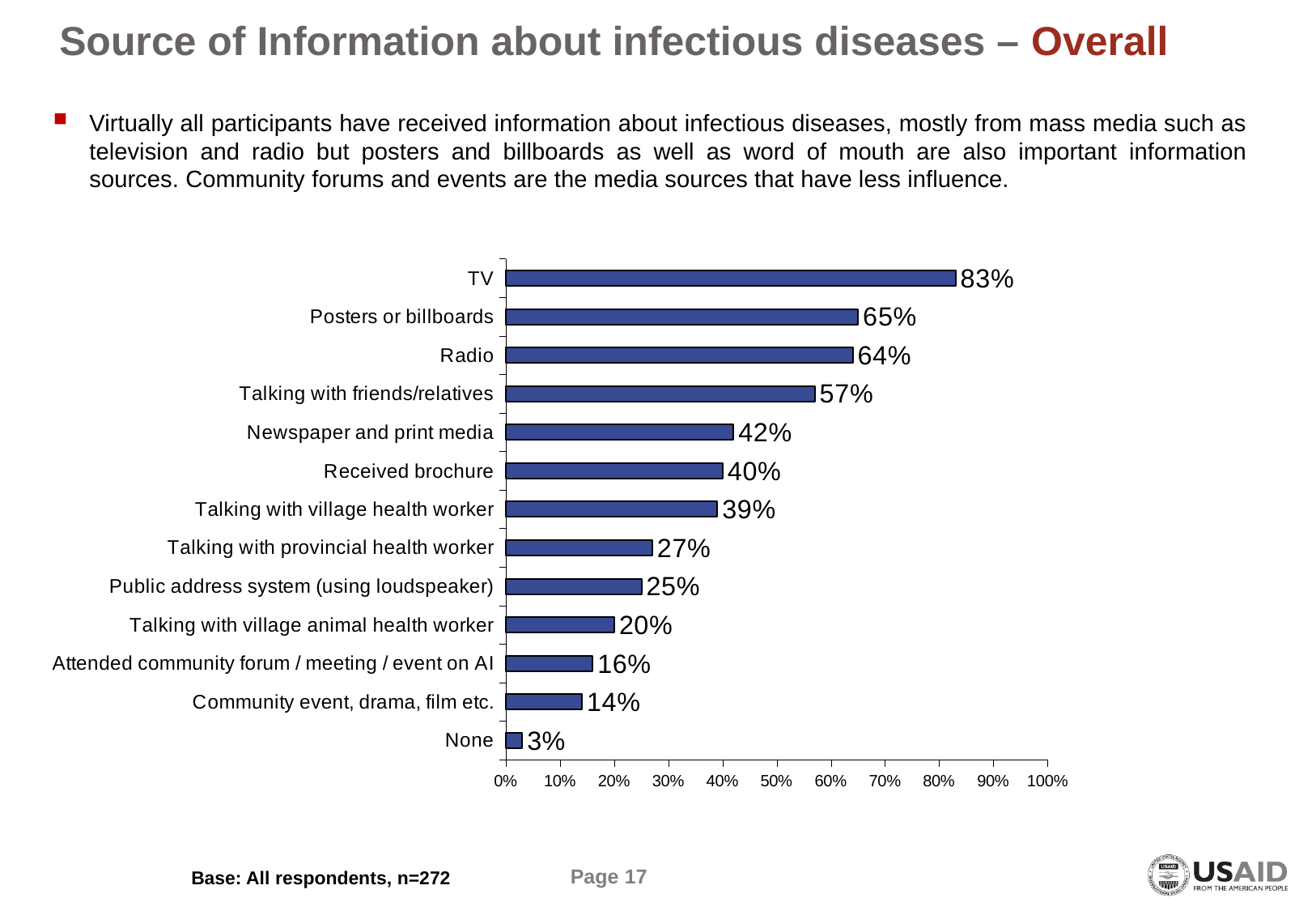
What is the difference between the values for TV and Talking with friends/relatives? 26% What is the base (sample size) stated for the chart? All respondents, n=272 Which is larger, the value for Newspaper and print media or the value for Received brochure? Newspaper and print media What percentage of respondents received information about infectious diseases from TV? 83% What kind of chart is shown on the slide? Bar chart Which category has the lowest value? None What is the value for Talking with village health worker? 39% How many categories are shown in the chart? 13 Which source of information has the highest value? TV What is the value for Public address system (using loudspeaker)? 25% Is the value for Talking with provincial health worker greater or less than 30%? less What is the difference between the values for Posters or billboards and Radio? 1%